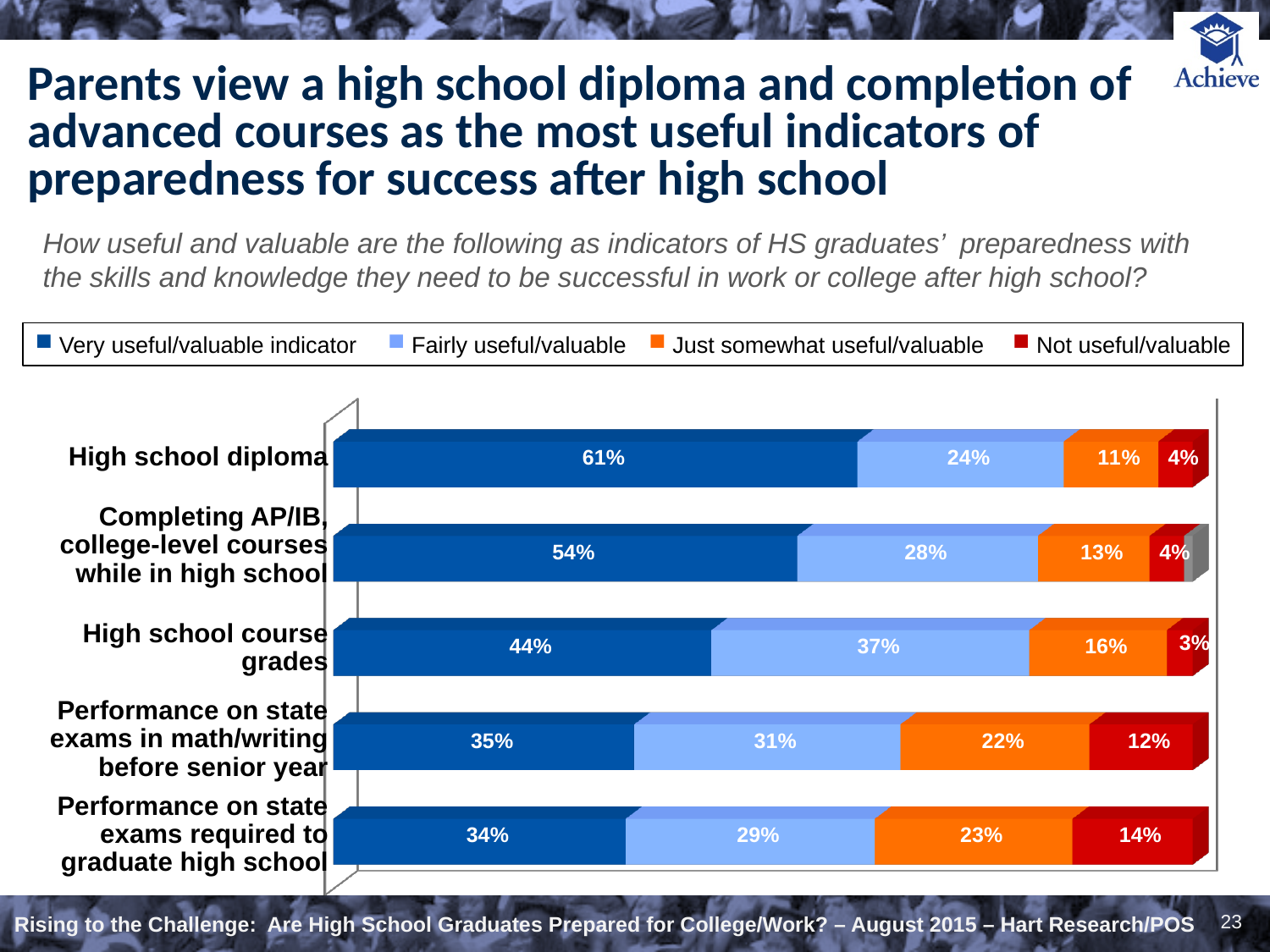
What percentage of parents say performance on state exams required to graduate high school is not useful/valuable? 14% Which indicator has the lowest share of parents rating it very useful/valuable? Performance on state exams required to graduate high school How many indicators are shown in the chart? 5 How many response categories does the legend list? 4 What colour represents the 'Not useful/valuable' response in the chart? Red Which has a larger fairly useful/valuable share: high school course grades or completing AP/IB, college-level courses while in high school? High school course grades How many percentage points higher is the very useful/valuable share for a high school diploma than for completing AP/IB, college-level courses while in high school? 7 percentage points What is the total of the four segments for the high school diploma bar? 100% Which indicator has the highest share of parents rating it very useful/valuable? High school diploma What percentage of parents rate a high school diploma as a very useful/valuable indicator? 61% What percentage of parents rate high school course grades as just somewhat useful/valuable? 16% What type of chart is shown on the slide? Stacked bar chart